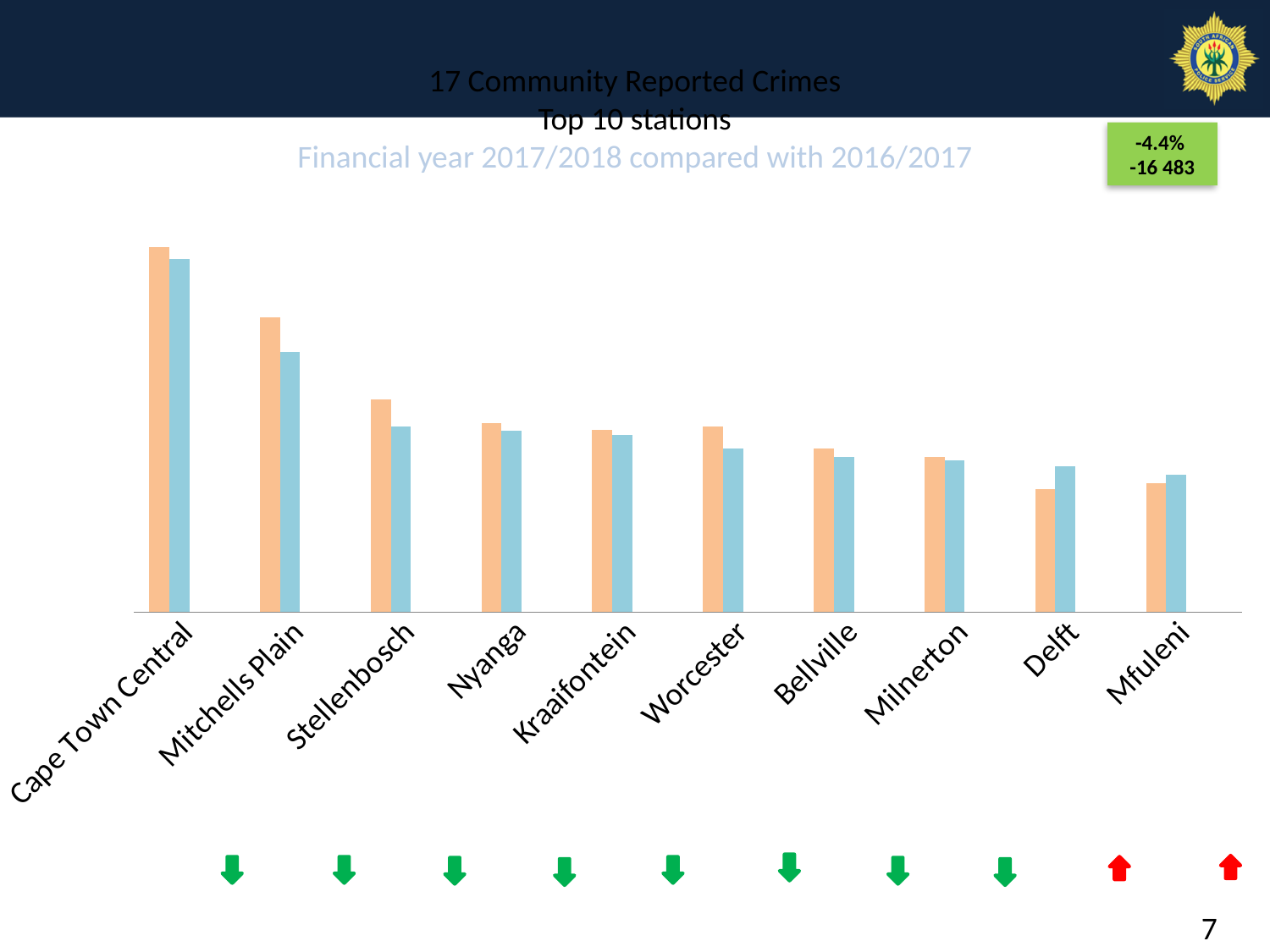
Do the bar heights generally rise or fall from left to right across the stations? Fall Which station has taller bars, Mitchells Plain or Stellenbosch? Mitchells Plain Which station has the highest bars in the chart? Cape Town Central How many police stations are shown on the x axis of the chart? 10 How many stations are marked with a red upward arrow below the chart? 2 What kind of chart is shown on the slide? Bar chart How many bars are plotted for each station? 2 Which station has a taller orange bar, Worcester or Bellville? Worcester For Delft, which bar is taller, the orange one or the blue one? The blue one Which station has the second-highest bars in the chart? Mitchells Plain What is the first line of the chart title? 17 Community Reported Crimes